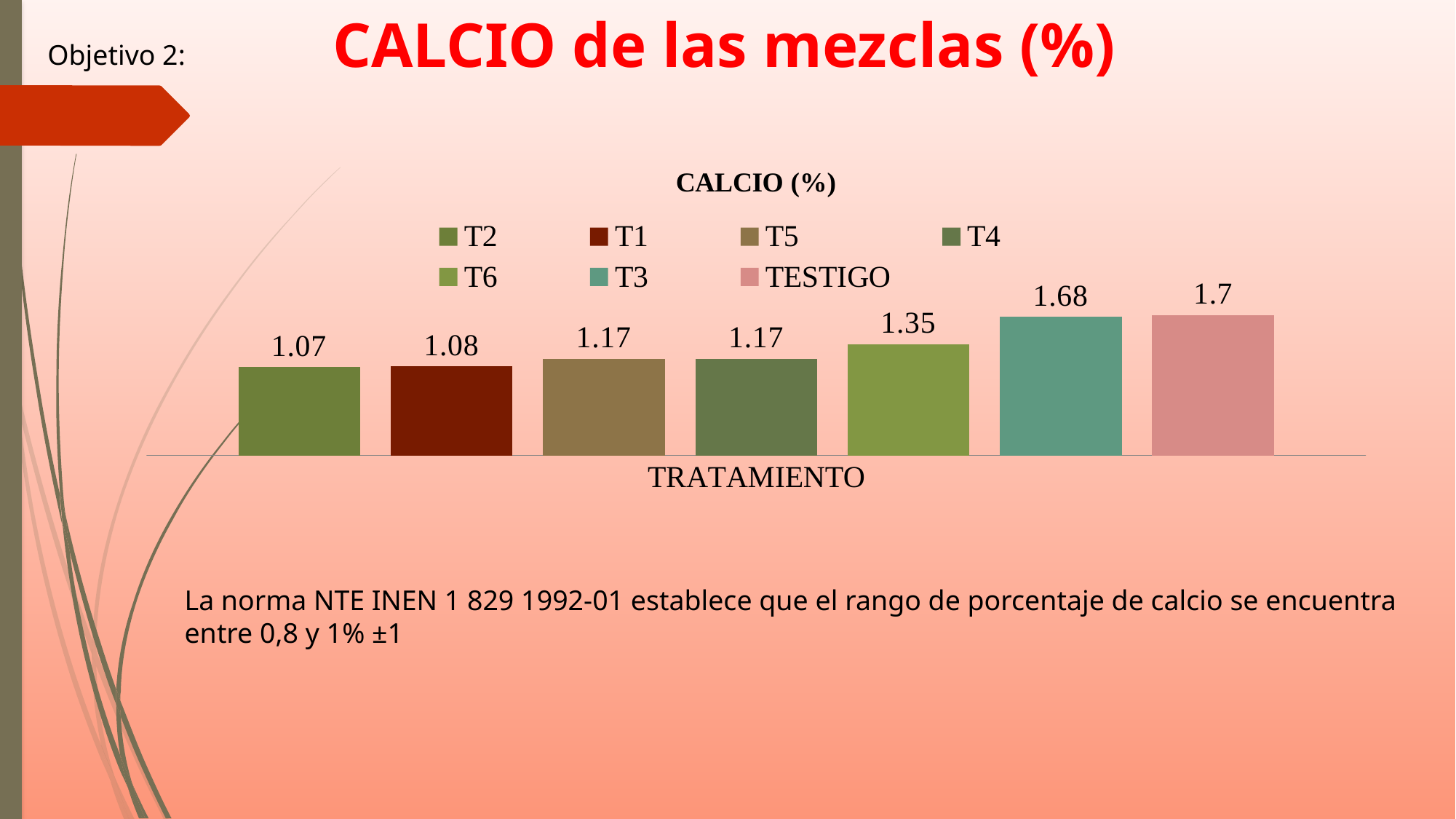
What is the difference between the calcium values of T6 and T1? 0.27 How many bars are shown in the chart? 7 What is the difference between the calcium values of TESTIGO and T2? 0.63 What is the calcium value for T2? 1.07 What is the calcium value for TESTIGO? 1.7 Which has a larger calcium value, T3 or T6? T3 Which treatment has the highest calcium value? TESTIGO What is the calcium value for T6? 1.35 What type of chart is shown on the slide? Bar chart How many entries does the legend list? 7 What is the calcium value for T3? 1.68 Which treatment has the lowest calcium value? T2